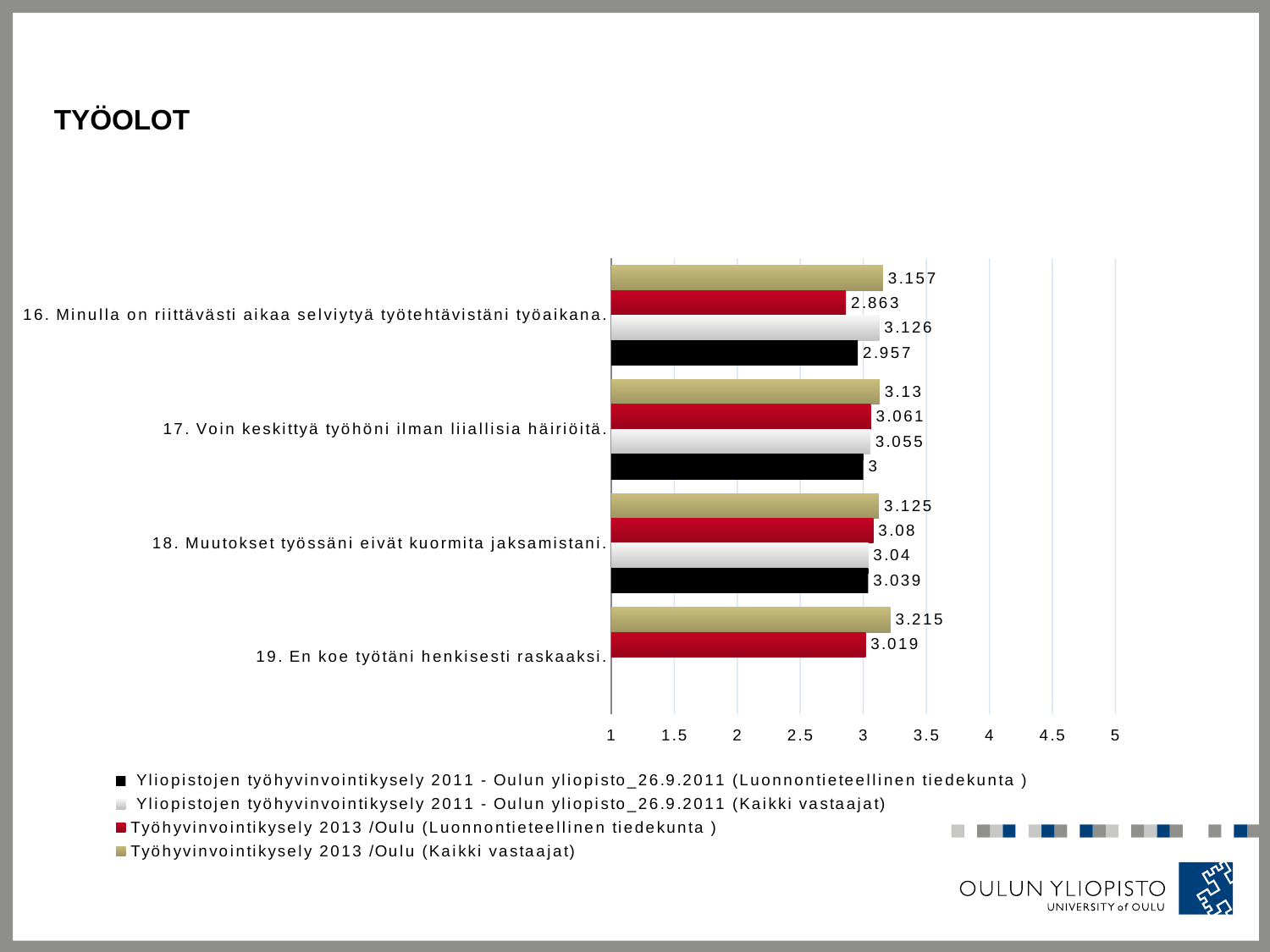
How many series does the legend list? 4 How many survey items (categories) are shown on the chart? 4 On item 19, what is the difference between the 2013 Kaikki vastaajat value and the 2013 Luonnontieteellinen tiedekunta value? 0.196 What is the lowest value shown on the chart? 2.863 What is the value for Yliopistojen työhyvinvointikysely 2011 (Luonnontieteellinen tiedekunta) on item 17 (Voin keskittyä työhöni ilman liiallisia häiriöitä)? 3 What is the value for Työhyvinvointikysely 2013 /Oulu (Luonnontieteellinen tiedekunta) on item 16 (Minulla on riittävästi aikaa selviytyä työtehtävistäni työaikana)? 2.863 What kind of chart is shown on the slide? bar chart On item 16, what is the difference between the 2013 Kaikki vastaajat value and the 2013 Luonnontieteellinen tiedekunta value? 0.294 What is the value for Työhyvinvointikysely 2013 /Oulu (Kaikki vastaajat) on item 19 (En koe työtäni henkisesti raskaaksi)? 3.215 Is the value for Työhyvinvointikysely 2013 /Oulu (Luonnontieteellinen tiedekunta) on item 16 greater or less than 3? less On item 16, which is larger: the 2011 Kaikki vastaajat value or the 2011 Luonnontieteellinen tiedekunta value? 2011 Kaikki vastaajat Which item has the highest value for Työhyvinvointikysely 2013 /Oulu (Kaikki vastaajat)? 19. En koe työtäni henkisesti raskaaksi.